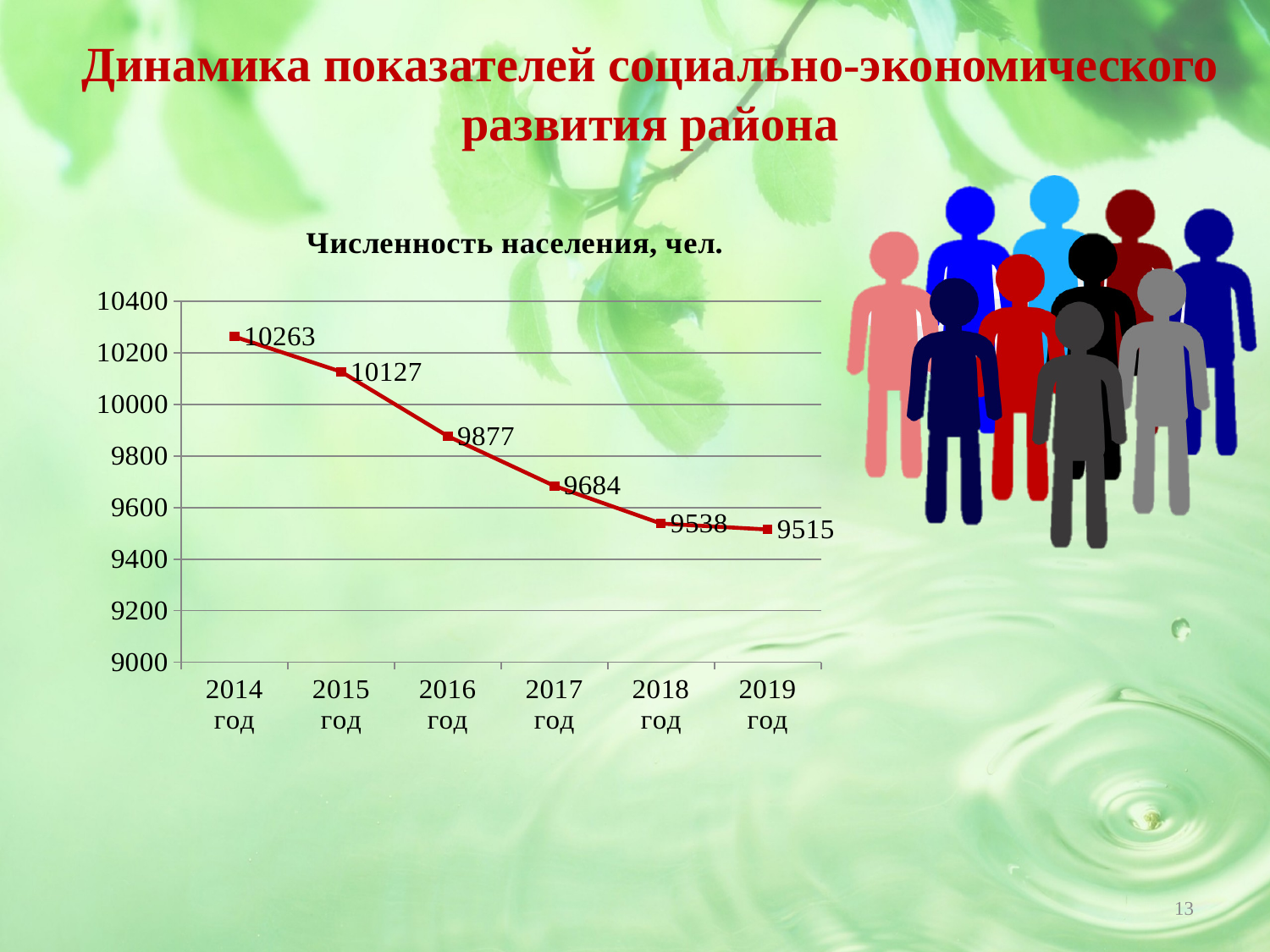
What is the difference between the population in 2014 год and 2019 год? 748 What is the population value for 2016 год? 9877 What kind of chart is shown on the slide? line chart What is the population value for 2014 год? 10263 Is the population value for 2017 год greater or less than 9800? less Which year has the highest population value? 2014 год How many years are plotted on the chart? 6 Which year has the lowest population value? 2019 год What is the population value for 2019 год? 9515 Which is larger, the population in 2017 год or in 2018 год? 2017 год What is the difference between the population in 2015 год and 2016 год? 250 Do the population values rise or fall from 2014 год to 2019 год? fall